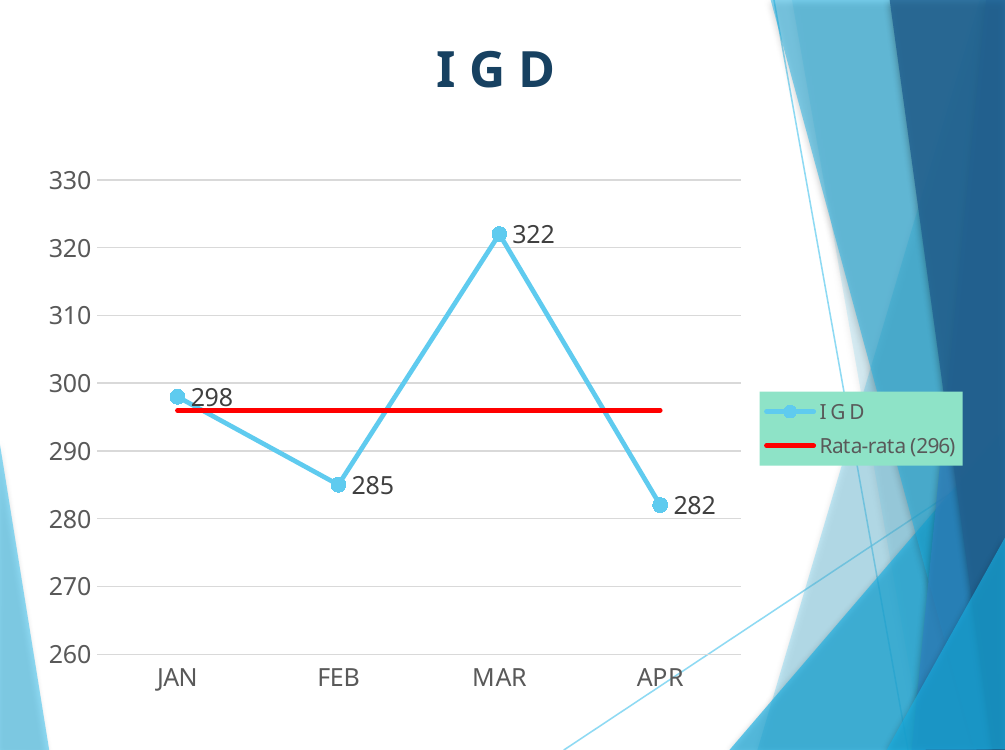
Which month has the lowest I G D value? APR Is the I G D value for MAR greater or less than 320? greater Which month has the highest I G D value? MAR How many series does the legend list? 2 What is the I G D value for JAN? 298 What is the I G D value for APR? 282 What is the difference between the I G D values for MAR and FEB? 37 What is the I G D value for FEB? 285 Which is larger, the I G D value for JAN or for APR? JAN What value does the legend give for the Rata-rata line? 296 What is the I G D value for MAR? 322 How many months are plotted on the x axis? 4